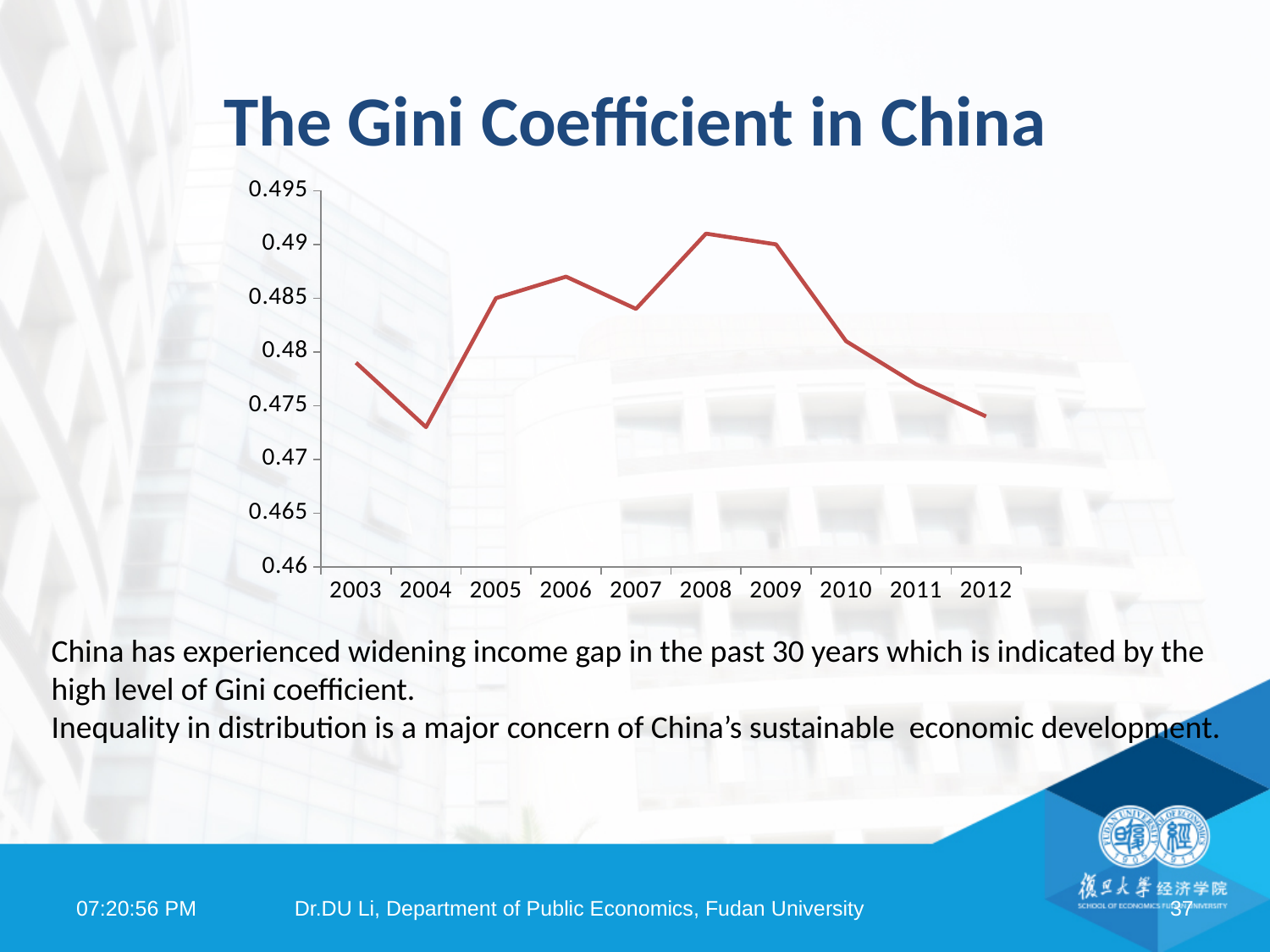
Which year has the lowest Gini coefficient in the chart? 2004 Is the value for 2006 greater or less than 0.485? greater What is the title of the chart? The Gini Coefficient in China Is the value for 2003 greater or less than 0.48? less How many years are plotted on the x axis of the chart? 10 Do the values rise or fall from 2004 to 2006? rise What kind of chart is shown on the slide? line chart Which year has the larger Gini coefficient, 2006 or 2010? 2006 Do the values rise or fall from 2009 to 2012? fall Which year has the highest Gini coefficient in the chart? 2008 Is the value for 2004 greater or less than 0.475? less